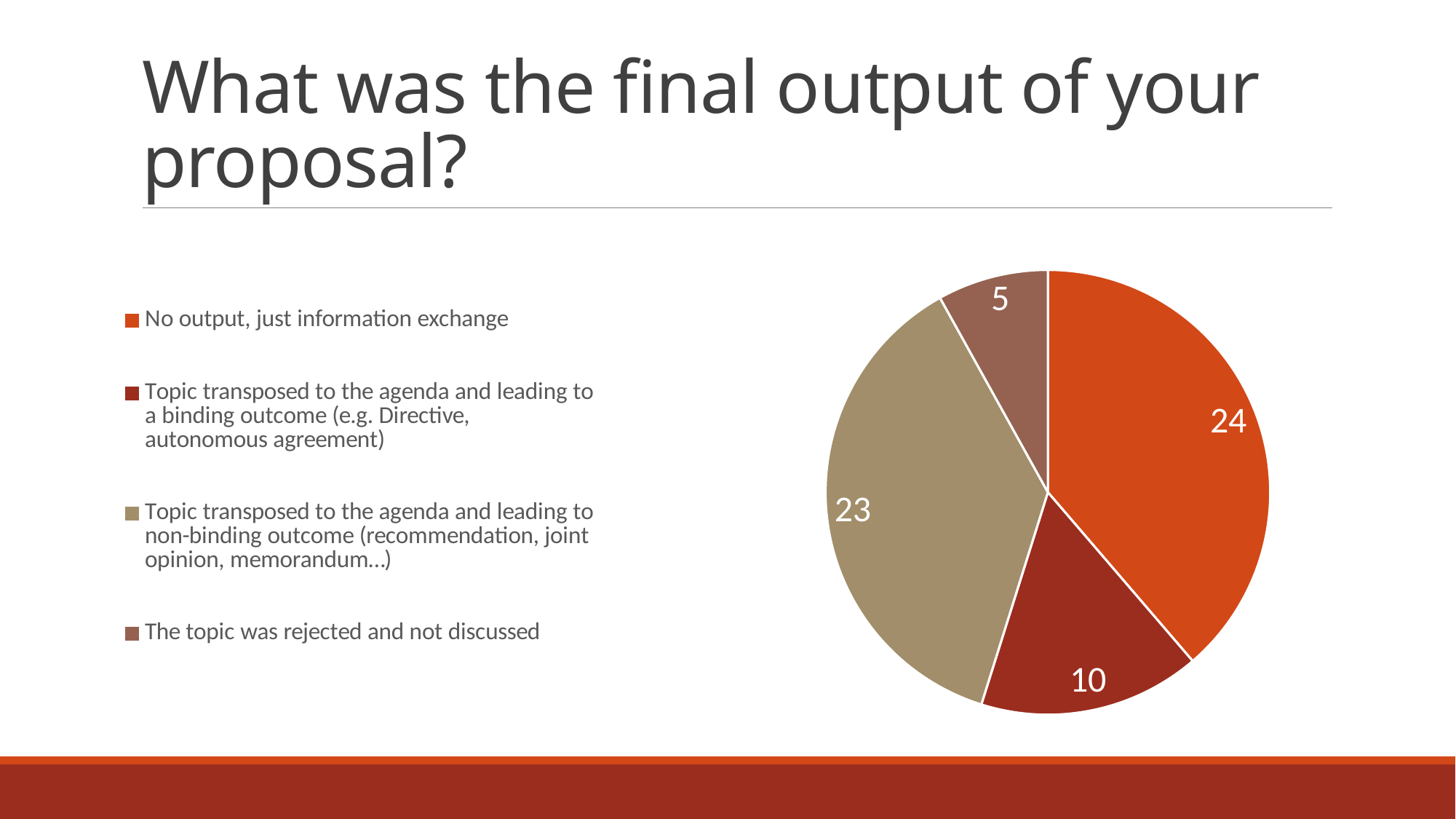
What is the total of all the slices in the pie chart? 62 What is the value for 'Topic transposed to the agenda and leading to a binding outcome (e.g. Directive, autonomous agreement)'? 10 What is the value for 'No output, just information exchange'? 24 Which category has the smallest slice of the pie? The topic was rejected and not discussed What is the title of the slide containing the pie chart? What was the final output of your proposal? How many categories does the pie chart have? 4 What is the value for 'Topic transposed to the agenda and leading to non-binding outcome (recommendation, joint opinion, memorandum…)'? 23 What type of chart is shown on the slide? pie chart What is the difference between the value for 'No output, just information exchange' and the value for 'The topic was rejected and not discussed'? 19 What is the value for 'The topic was rejected and not discussed'? 5 Which is larger: the value for 'No output, just information exchange' or the value for 'Topic transposed to the agenda and leading to non-binding outcome'? No output, just information exchange Which category has the largest slice of the pie? No output, just information exchange